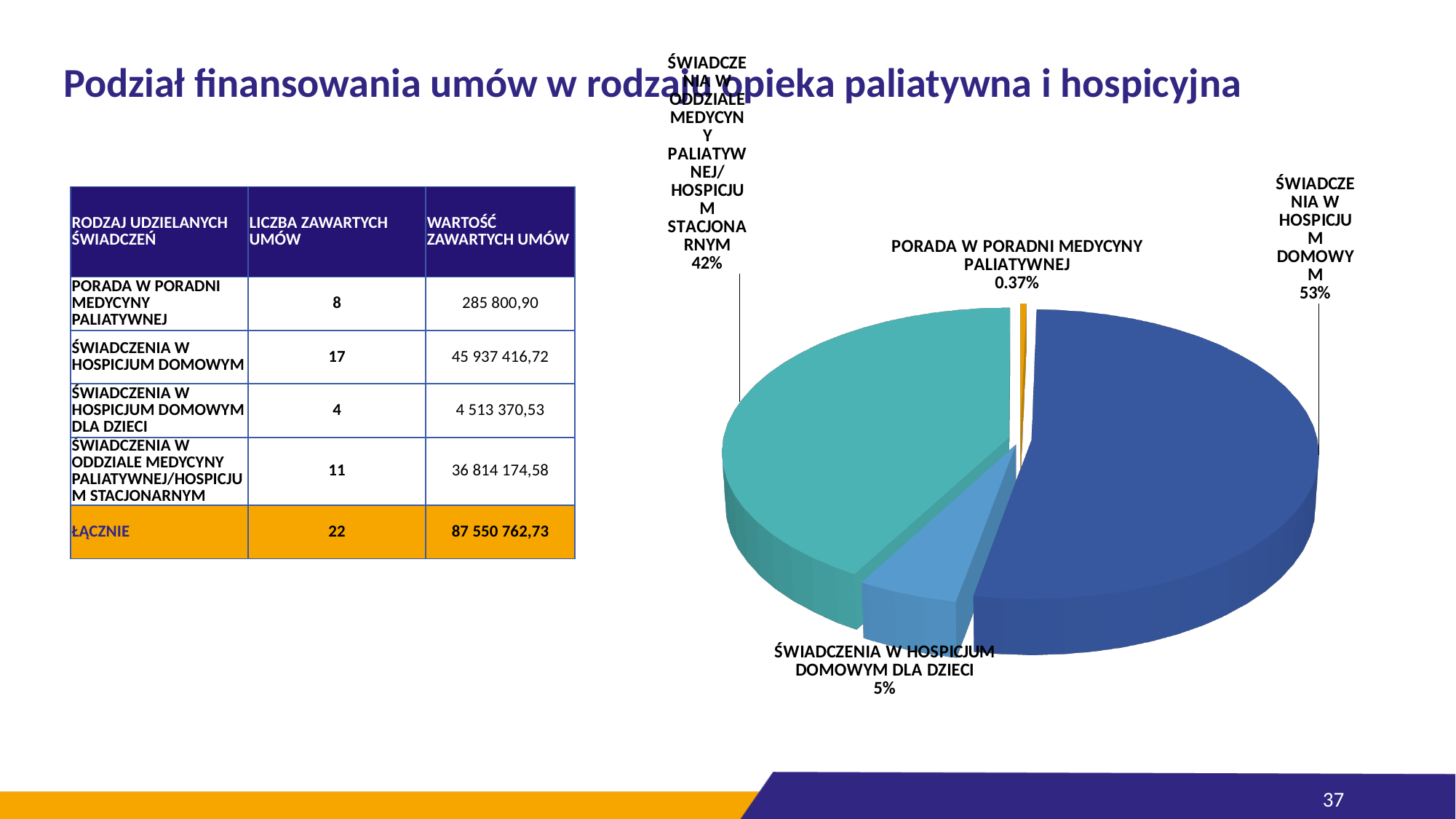
Which slice of the pie chart is the largest? ŚWIADCZENIA W HOSPICJUM DOMOWYM What is the difference in percentage points between the ŚWIADCZENIA W ODDZIALE MEDYCYNY PALIATYWNEJ/HOSPICJUM STACJONARNYM slice and the ŚWIADCZENIA W HOSPICJUM DOMOWYM DLA DZIECI slice? 37 percentage points What share of the pie does ŚWIADCZENIA W ODDZIALE MEDYCYNY PALIATYWNEJ/HOSPICJUM STACJONARNYM have? 42% What kind of chart is shown on the slide? pie chart How many slices does the pie chart have? 4 Which is larger in the pie chart: ŚWIADCZENIA W HOSPICJUM DOMOWYM or ŚWIADCZENIA W ODDZIALE MEDYCYNY PALIATYWNEJ/HOSPICJUM STACJONARNYM? ŚWIADCZENIA W HOSPICJUM DOMOWYM What is the difference in percentage points between the ŚWIADCZENIA W HOSPICJUM DOMOWYM slice and the ŚWIADCZENIA W ODDZIALE MEDYCYNY PALIATYWNEJ/HOSPICJUM STACJONARNYM slice? 11 percentage points What share of the pie does ŚWIADCZENIA W HOSPICJUM DOMOWYM DLA DZIECI have? 5% What share of the pie does ŚWIADCZENIA W HOSPICJUM DOMOWYM have? 53% What colour is the ŚWIADCZENIA W HOSPICJUM DOMOWYM slice in the pie chart? dark blue Which slice of the pie chart is the smallest? PORADA W PORADNI MEDYCYNY PALIATYWNEJ